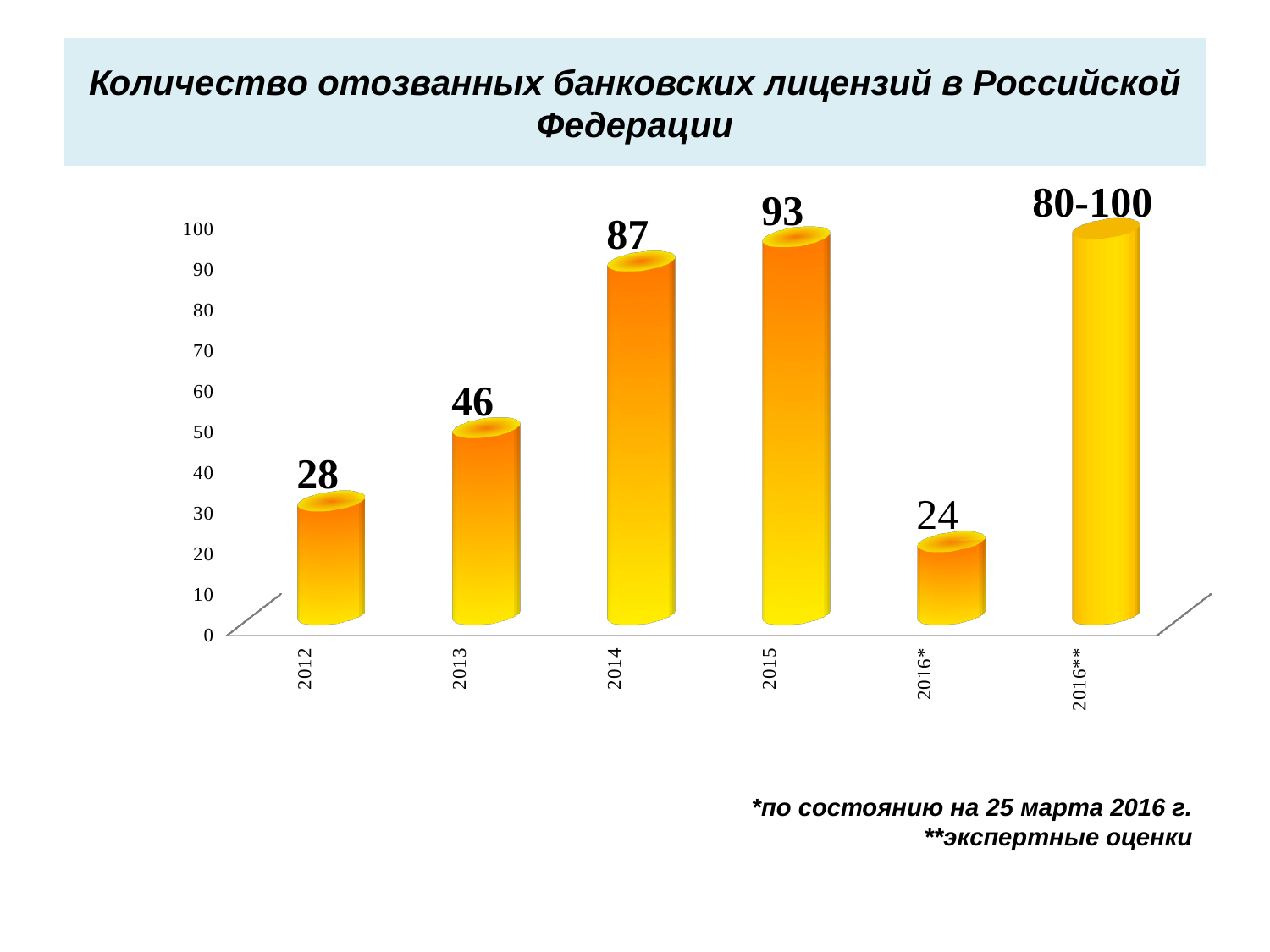
What is the value for 2015? 93 Do the values rise or fall from 2012 to 2015? Rise What is the value labelled for 2016**? 80-100 What is the value for 2014? 87 How many categories are shown on the x axis? 6 Which category has the lowest value? 2016* What is the difference between the values for 2013 and 2012? 18 What kind of chart is shown on the slide? Bar chart What is the difference between the values for 2015 and 2014? 6 What is the value for 2012? 28 Which is larger, the value for 2013 or the value for 2016*? 2013 Which of 2012 to 2015 has the highest value? 2015